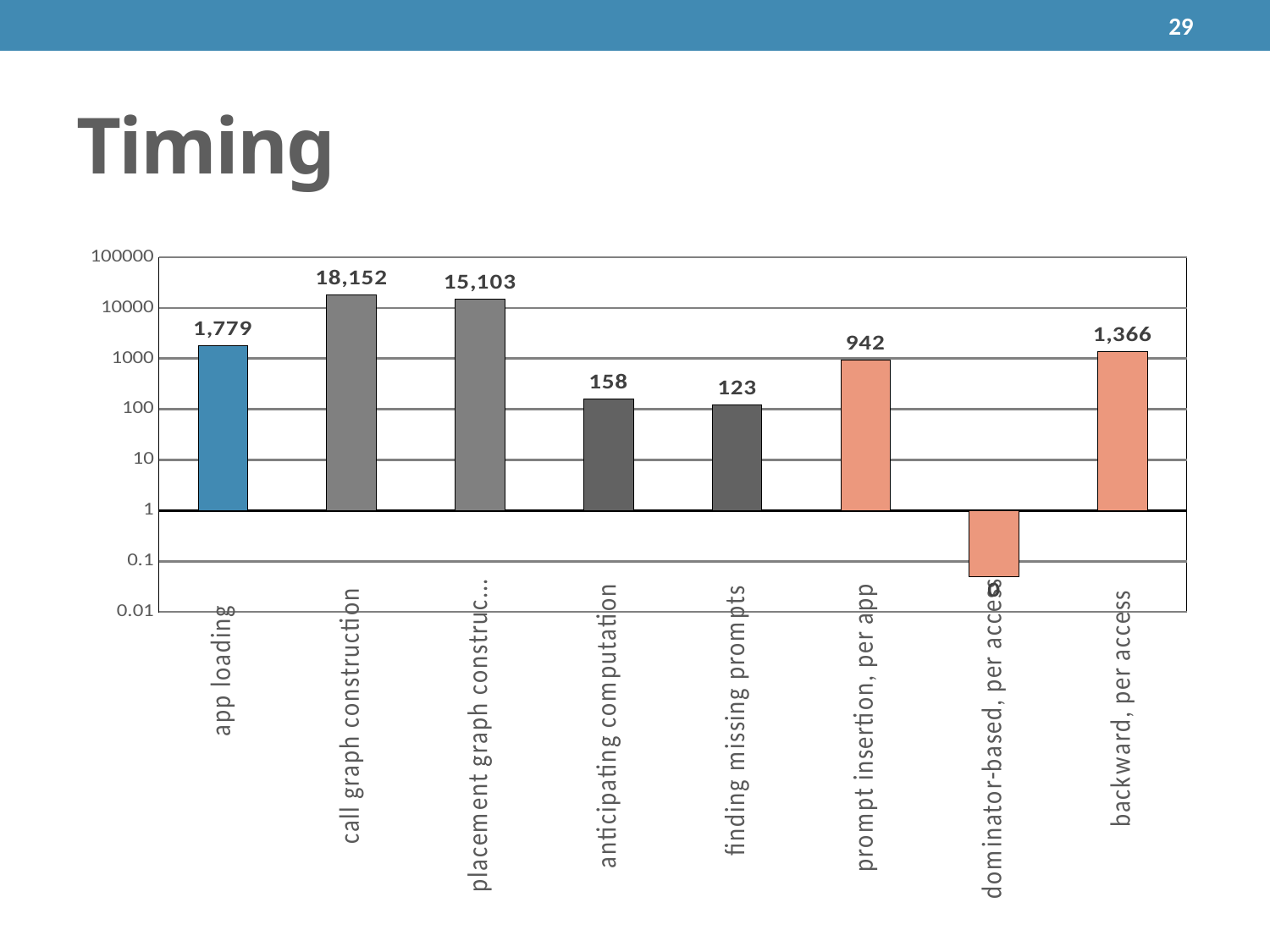
What kind of chart is shown on the slide? bar chart What is the value for call graph construction? 18,152 Which category has the highest value? call graph construction What is the value for prompt insertion, per app? 942 Which is larger, the value for prompt insertion, per app or the value for backward, per access? backward, per access Which category has the lowest value? dominator-based, per access What is the difference between the values for call graph construction and placement graph construction? 3,049 How many categories are shown on the x axis? 8 Is the value for dominator-based, per access greater or less than 1? less What is the value for finding missing prompts? 123 What is the value for app loading? 1,779 What is the difference between the values for anticipating computation and finding missing prompts? 35